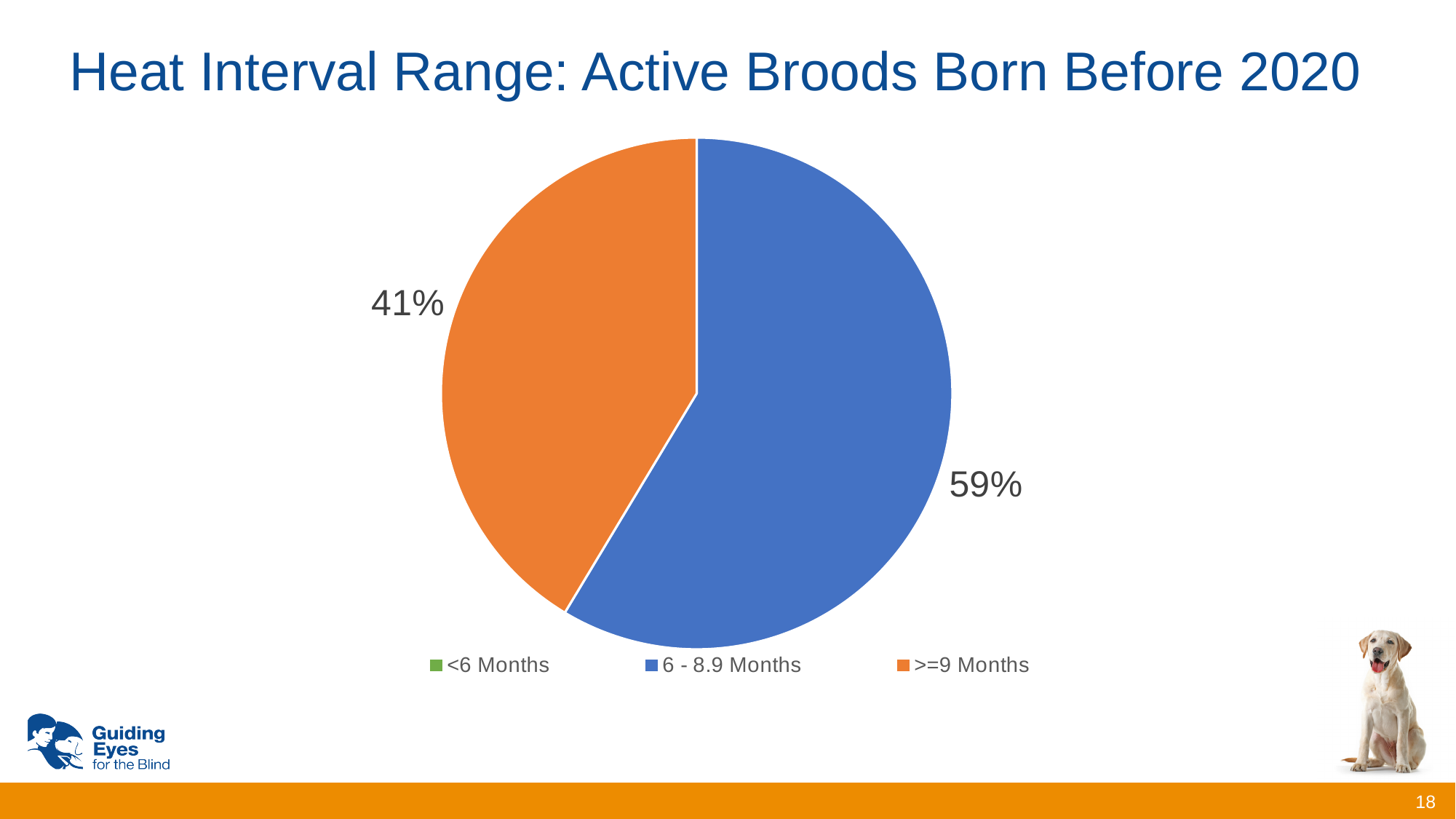
Is the share for >=9 Months greater or less than 50%? less What colour is the slice for >=9 Months? orange Which category has the largest share of the pie? 6 - 8.9 Months How many categories does the legend list? 3 What share of the pie does the 6 - 8.9 Months category have? 59% What kind of chart is shown on the slide? pie chart What is the title of the chart? Heat Interval Range: Active Broods Born Before 2020 Is the share for 6 - 8.9 Months greater or less than 50%? greater What is the difference in percentage points between the 6 - 8.9 Months share and the >=9 Months share? 18% What share of the pie does the >=9 Months category have? 41% Which of the two visible slices is larger, 6 - 8.9 Months or >=9 Months? 6 - 8.9 Months